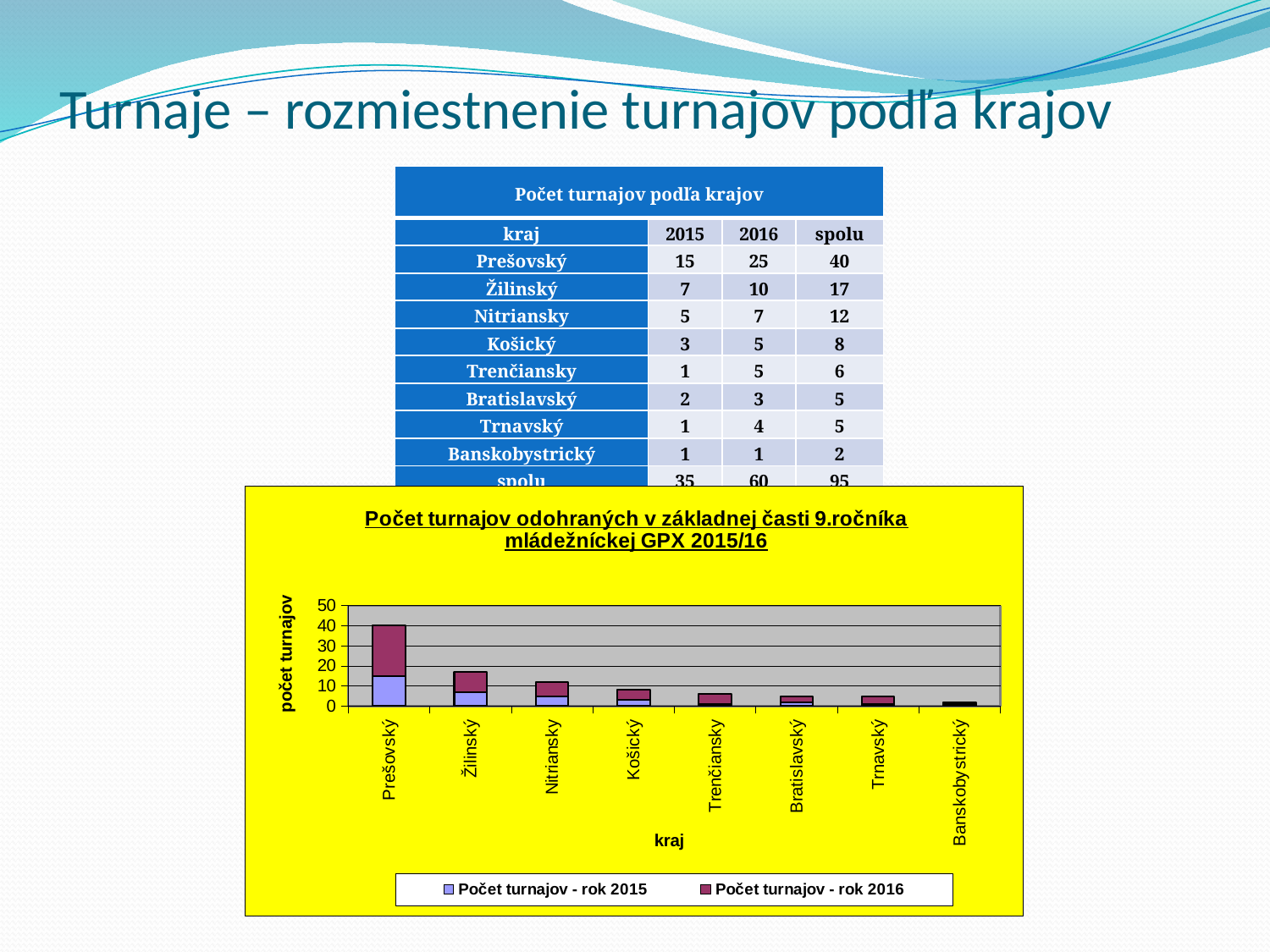
Which region has the tallest stacked bar in the chart? Prešovský What is the label of the y axis of the chart? počet turnajov How many series does the chart legend list? 2 How many regions (kraj) are shown on the x axis of the chart? 8 What is the total of the stacked bar for Prešovský (2015 plus 2016)? 40 Do the stacked bar totals rise or fall moving from left to right along the x axis? fall Which is larger: the stacked bar for Košický or the stacked bar for Trenčiansky? Košický What kind of chart is shown on the slide? bar chart Is the total stacked bar for Prešovský greater or less than 30? greater Is the total stacked bar for Žilinský greater or less than 20? less Which region has the shortest stacked bar in the chart? Banskobystrický What is the value for Nitriansky in the series 'Počet turnajov - rok 2016'? 7